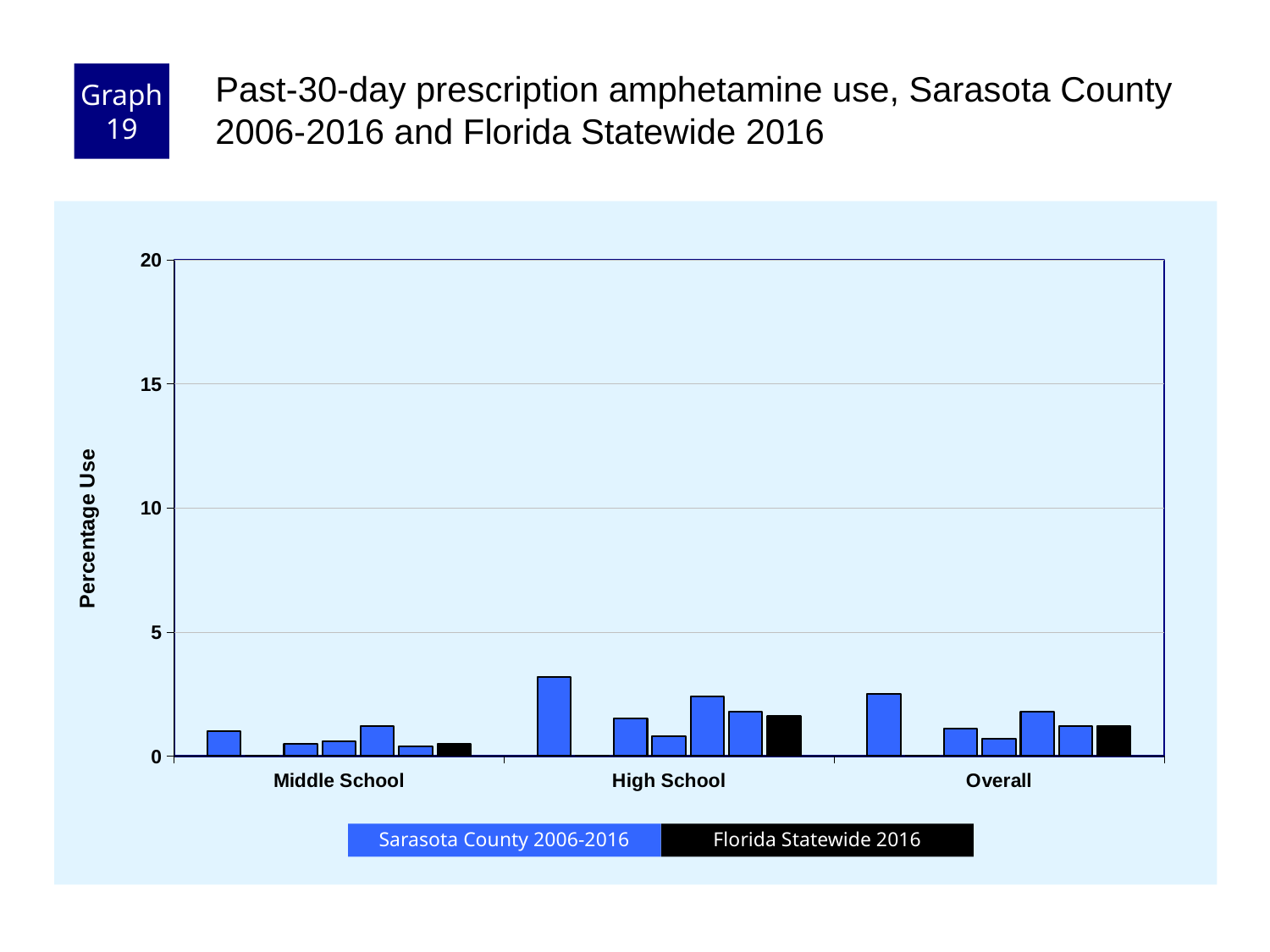
Which category group has the lowest bars overall? Middle School What is the label on the y axis? Percentage Use Is the Florida Statewide 2016 value for Overall larger or smaller than the Florida Statewide 2016 value for Middle School? larger Is the tallest Sarasota County bar in the High School group greater or less than 5? less What kind of chart is shown on the slide? bar chart Which colour represents Florida Statewide 2016 in the legend? black Is the Florida Statewide 2016 value for High School greater or less than 5? less Is the Florida Statewide 2016 value for Middle School greater or less than 5? less Is the Florida Statewide 2016 value for High School larger or smaller than the Florida Statewide 2016 value for Middle School? larger How many school-level categories are shown along the x axis? 3 How many series does the legend list? 2 Which category group contains the tallest bar on the chart? High School